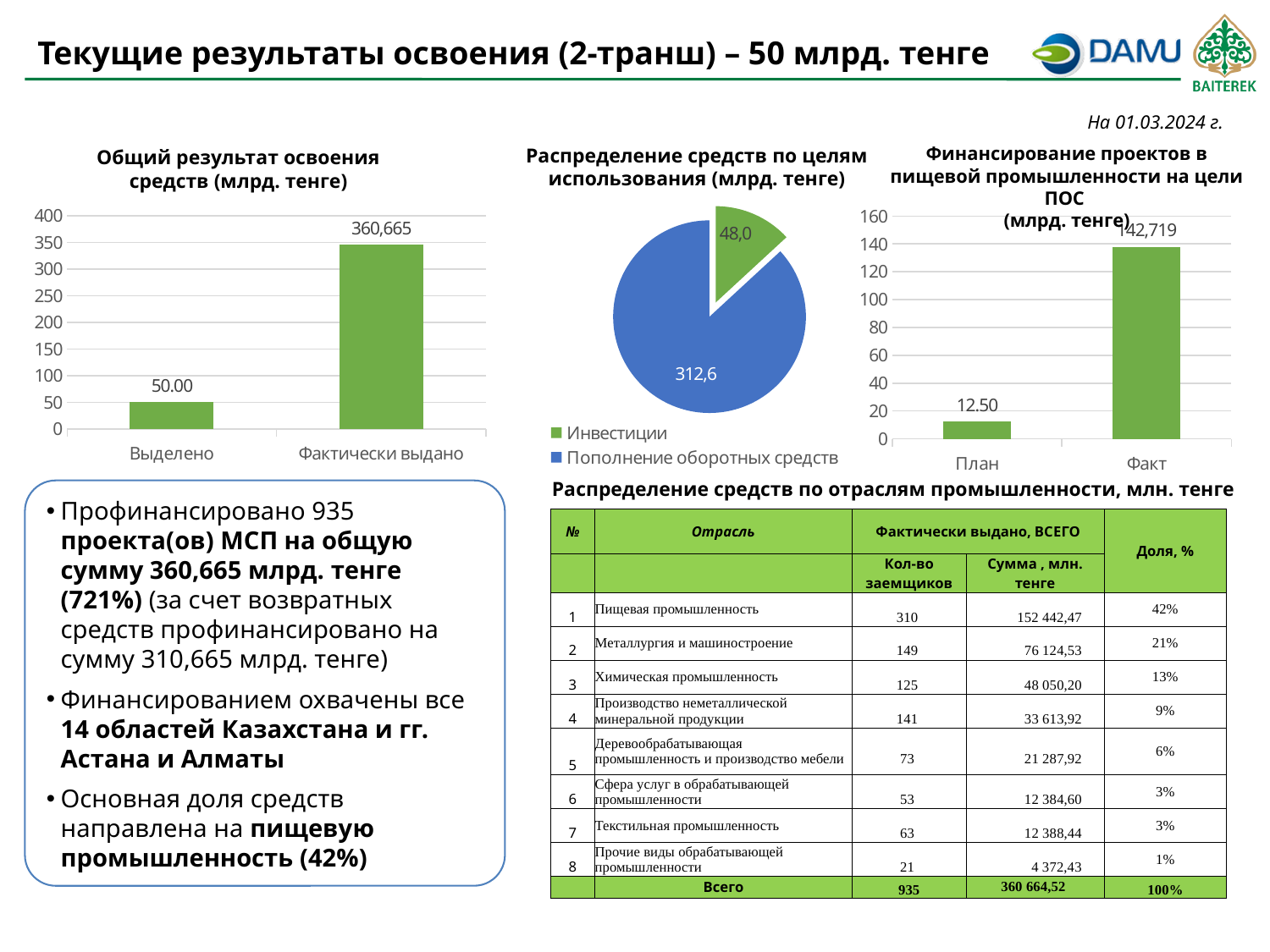
How many categories are shown on the x axis of the chart 'Финансирование проектов в пищевой промышленности на цели ПОС (млрд. тенге)'? 2 In the chart 'Общий результат освоения средств (млрд. тенге)', what is the value for 'Выделено'? 50.00 In the pie chart 'Распределение средств по целям использования (млрд. тенге)', which slice is larger: 'Инвестиции' or 'Пополнение оборотных средств'? Пополнение оборотных средств In the chart 'Общий результат освоения средств (млрд. тенге)', what is the difference between 'Фактически выдано' and 'Выделено'? 310,665 In the chart 'Общий результат освоения средств (млрд. тенге)', what is the value for 'Фактически выдано'? 360,665 In the pie chart 'Распределение средств по целям использования (млрд. тенге)', what is the value for 'Инвестиции'? 48,0 What kind of chart is 'Общий результат освоения средств (млрд. тенге)'? Bar chart How many entries does the legend of the pie chart 'Распределение средств по целям использования (млрд. тенге)' list? 2 In the pie chart 'Распределение средств по целям использования (млрд. тенге)', what is the value for 'Пополнение оборотных средств'? 312,6 In the chart 'Финансирование проектов в пищевой промышленности на цели ПОС (млрд. тенге)', which category has the highest value? Факт In the chart 'Финансирование проектов в пищевой промышленности на цели ПОС (млрд. тенге)', what is the value for 'План'? 12.50 In the chart 'Финансирование проектов в пищевой промышленности на цели ПОС (млрд. тенге)', what is the value for 'Факт'? 142,719